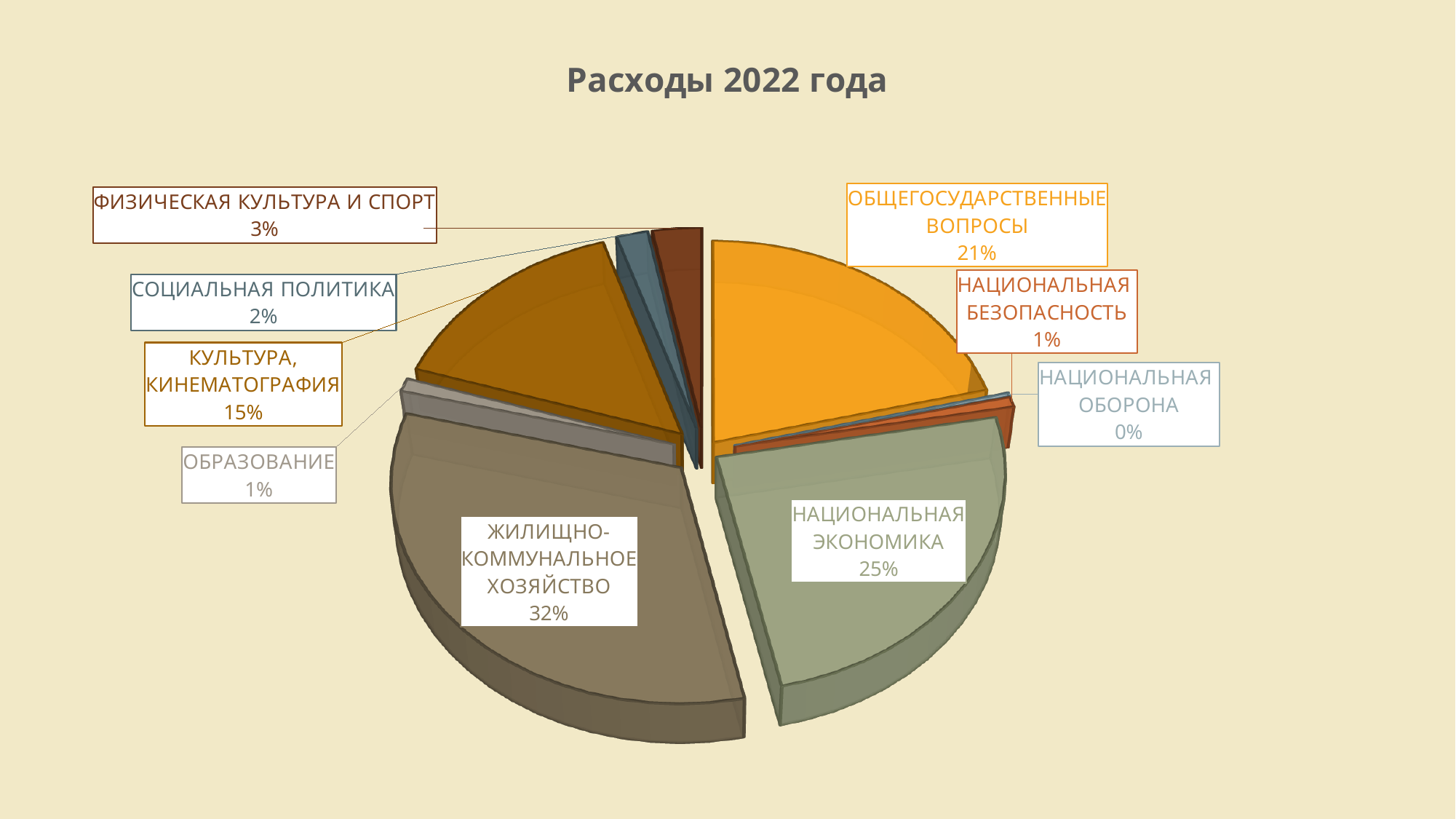
What percentage is shown for ФИЗИЧЕСКАЯ КУЛЬТУРА И СПОРТ? 3% What share of the pie does ЖИЛИЩНО-КОММУНАЛЬНОЕ ХОЗЯЙСТВО have? 32% How many categories are shown in the pie chart? 9 What percentage is shown for НАЦИОНАЛЬНАЯ ЭКОНОМИКА? 25% Which category has the largest share of the pie? ЖИЛИЩНО-КОММУНАЛЬНОЕ ХОЗЯЙСТВО What percentage is shown for ОБЩЕГОСУДАРСТВЕННЫЕ ВОПРОСЫ? 21% What is the title of the chart? Расходы 2022 года Which category has the smallest share of the pie? НАЦИОНАЛЬНАЯ ОБОРОНА Which is larger: ОБЩЕГОСУДАРСТВЕННЫЕ ВОПРОСЫ or КУЛЬТУРА, КИНЕМАТОГРАФИЯ? ОБЩЕГОСУДАРСТВЕННЫЕ ВОПРОСЫ What is the difference in percentage points between ЖИЛИЩНО-КОММУНАЛЬНОЕ ХОЗЯЙСТВО and НАЦИОНАЛЬНАЯ ЭКОНОМИКА? 7 What percentage is shown for КУЛЬТУРА, КИНЕМАТОГРАФИЯ? 15% What type of chart is shown on the slide? Pie chart